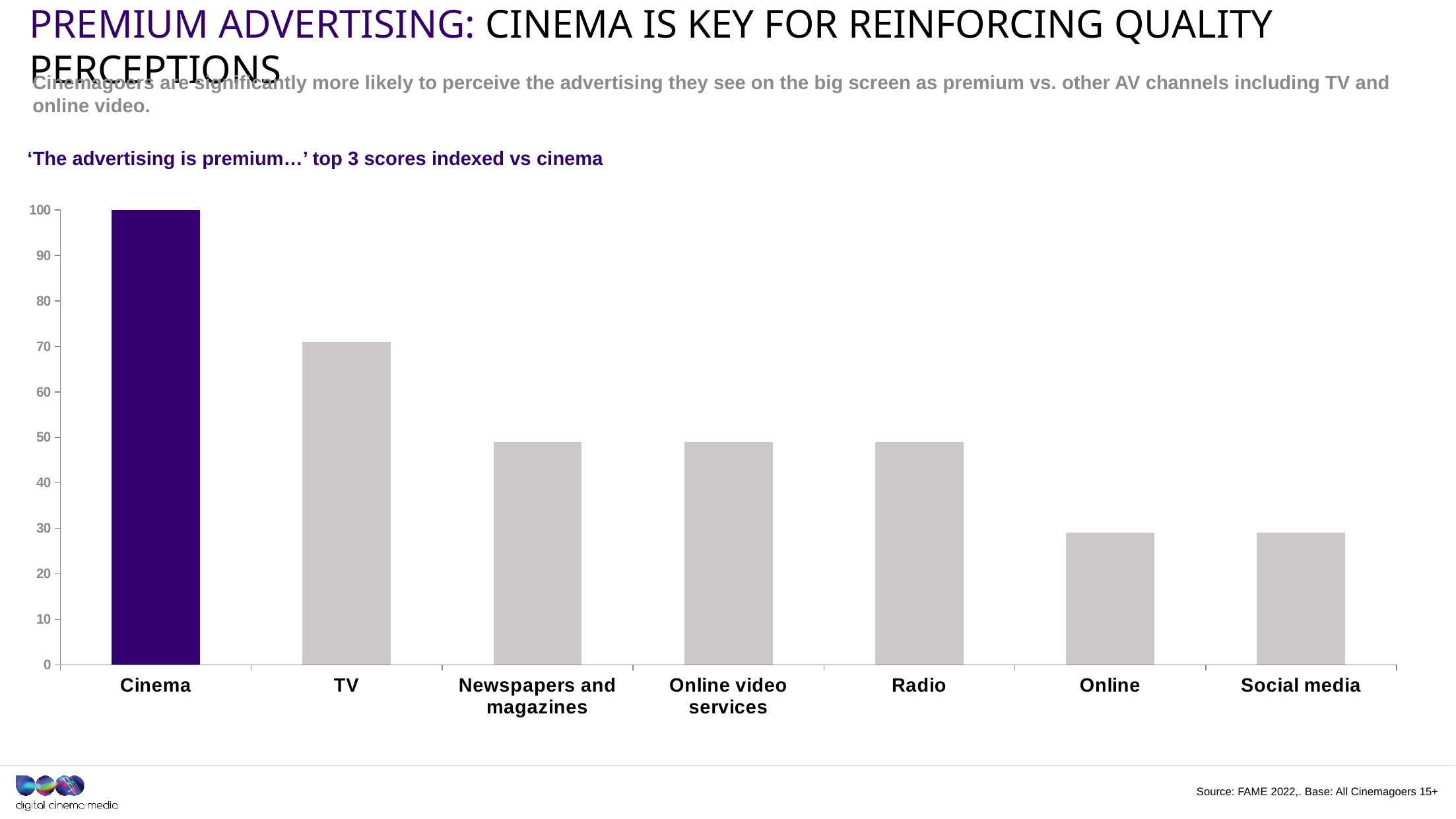
Is the value for Newspapers and magazines greater or less than 40? greater Which bar is coloured dark purple rather than grey? Cinema What type of chart is shown on the slide? bar chart Is the value for TV greater or less than 60? greater How many categories are plotted on the chart? 7 What is the indexed value for Cinema? 100 Which category has the highest value? Cinema Which is larger, the value for Online video services or the value for Social media? Online video services Do the values generally rise or fall moving from left to right along the x axis? fall Which is larger, the value for TV or the value for Radio? TV